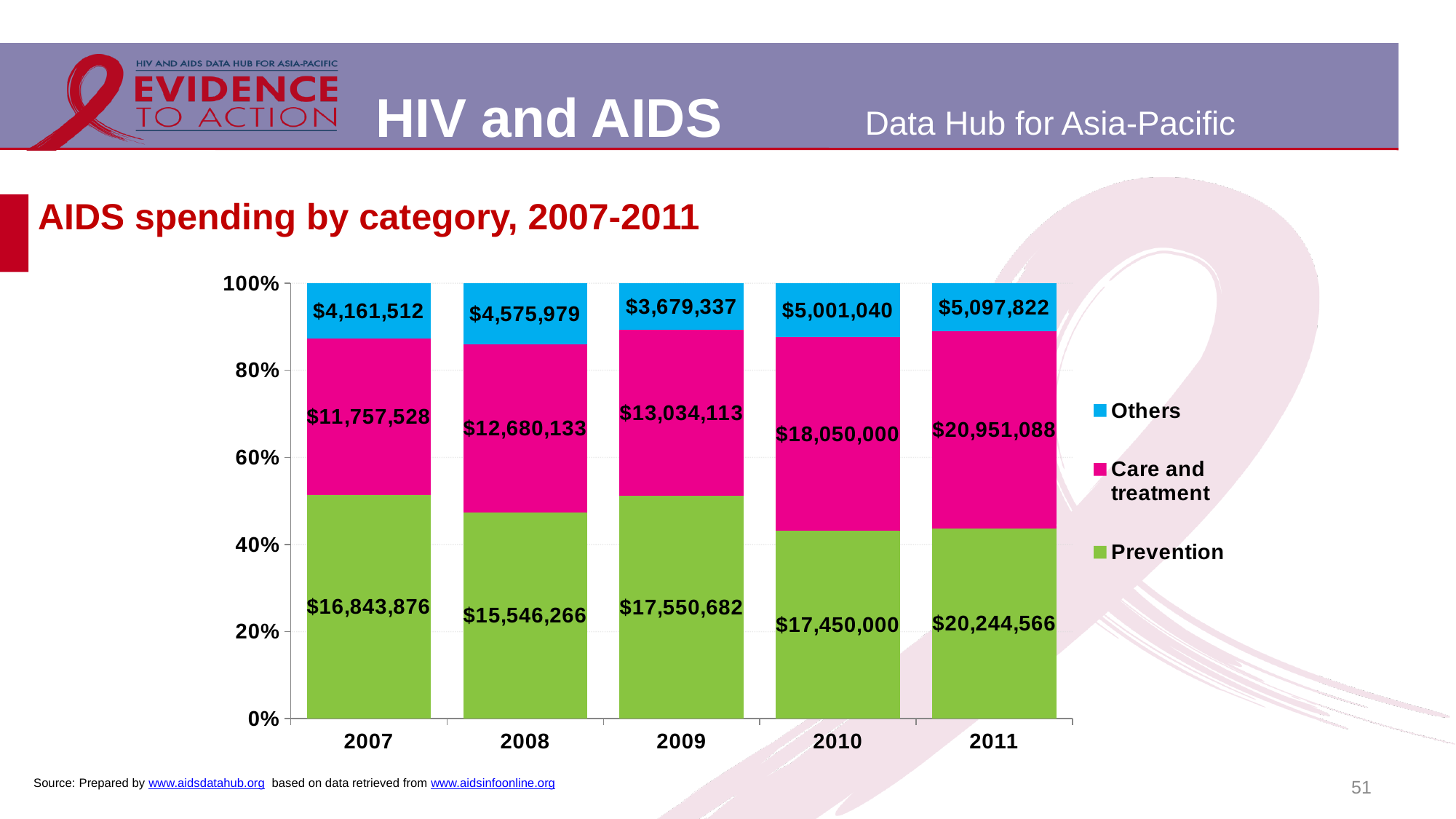
What was the Care and treatment spending in 2010? $18,050,000 In which year was Others spending lowest? 2009 What type of chart is shown on the slide? stacked bar chart What was the Others spending in 2008? $4,575,979 Is the Prevention share of spending in 2010 greater or less than 50%? less What was the Prevention spending in 2009? $17,550,682 How many series does the legend list? 3 What is the total AIDS spending across all three categories in 2007? $32,762,916 What is the difference between Care and treatment and Prevention spending in 2011? $706,522 How many years are shown on the x axis? 5 Which was larger in 2008: Prevention spending or Care and treatment spending? Prevention In which year was Prevention spending highest? 2011